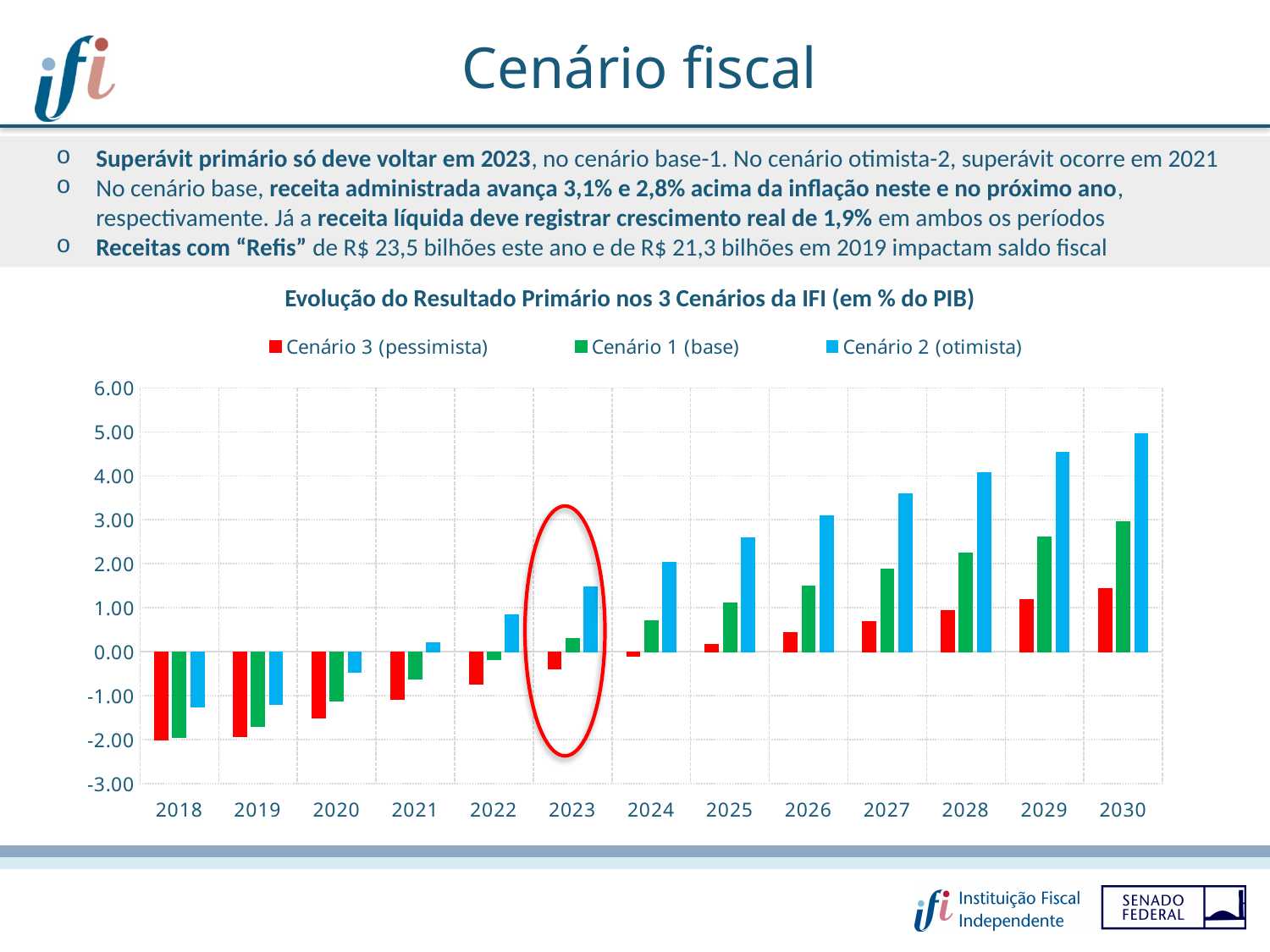
Is the value for Cenário 2 (otimista) in 2025 greater or less than 2.00? greater Do the values for Cenário 2 (otimista) rise or fall from 2018 to 2030? rise What kind of chart is shown on the slide? Bar chart Is the value for Cenário 1 (base) in 2030 greater or less than 2.00? greater How many years are shown on the x axis of the chart? 13 In 2023, which is larger: the value for Cenário 1 (base) or Cenário 3 (pessimista)? Cenário 1 (base) Which year on the chart is highlighted with a red circle? 2023 Is the value for Cenário 2 (otimista) in 2030 greater or less than 4.00? greater How many series does the chart legend list? 3 In 2030, which scenario has the highest value? Cenário 2 (otimista) In which year does Cenário 2 (otimista) reach its highest value? 2030